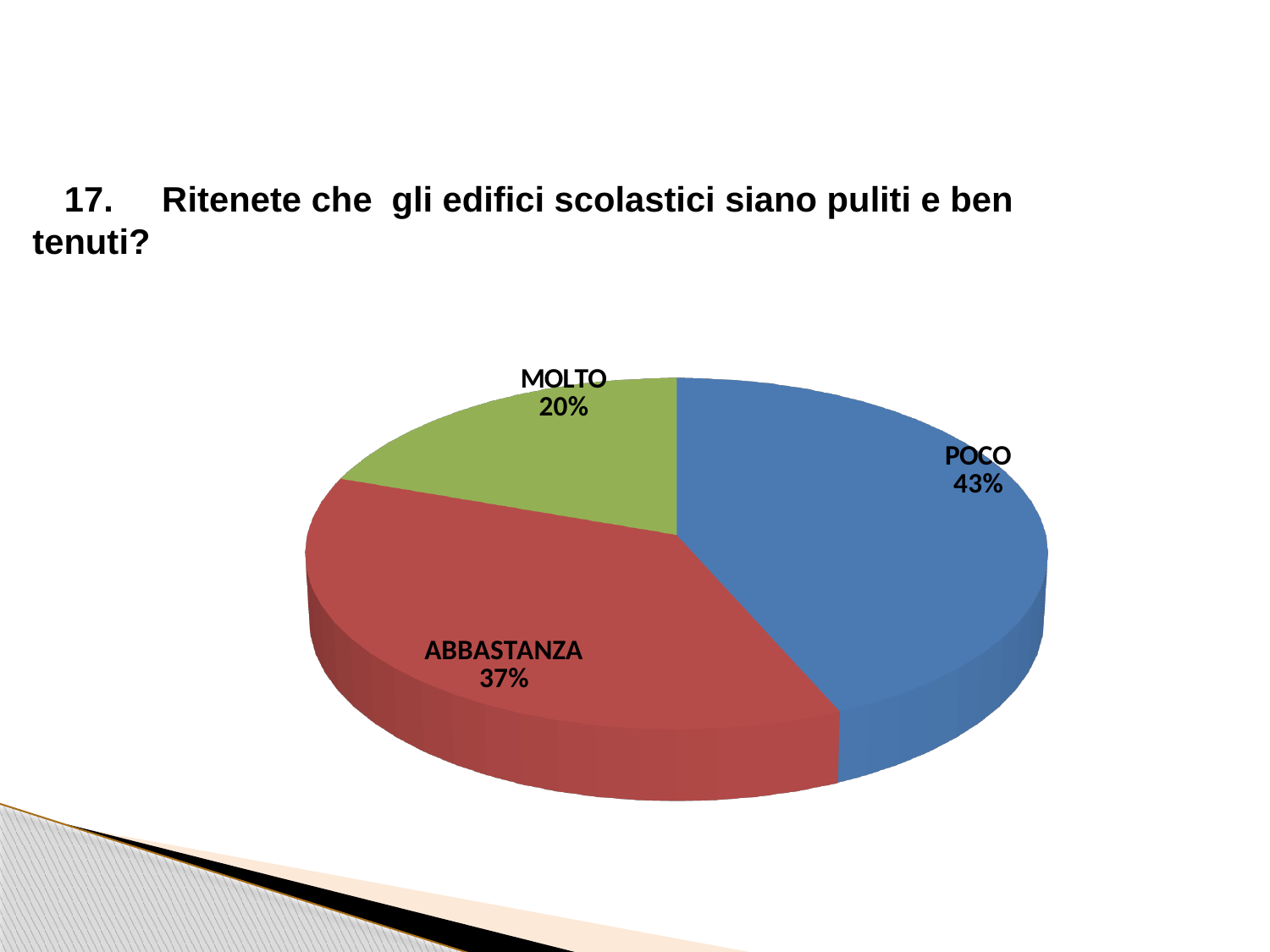
Which is larger, the share for ABBASTANZA or the share for MOLTO? ABBASTANZA How many slices does the pie chart have? 3 What is the difference in percentage points between ABBASTANZA and MOLTO? 17 What percentage of respondents answered POCO? 43% What kind of chart is shown on the slide? Pie chart What percentage of respondents answered ABBASTANZA? 37% What colour is the slice for POCO? Blue Which response has the smallest share of the pie? MOLTO What colour is the slice for MOLTO? Green What is the difference in percentage points between POCO and ABBASTANZA? 6 What percentage of respondents answered MOLTO? 20% Which response has the largest share of the pie? POCO